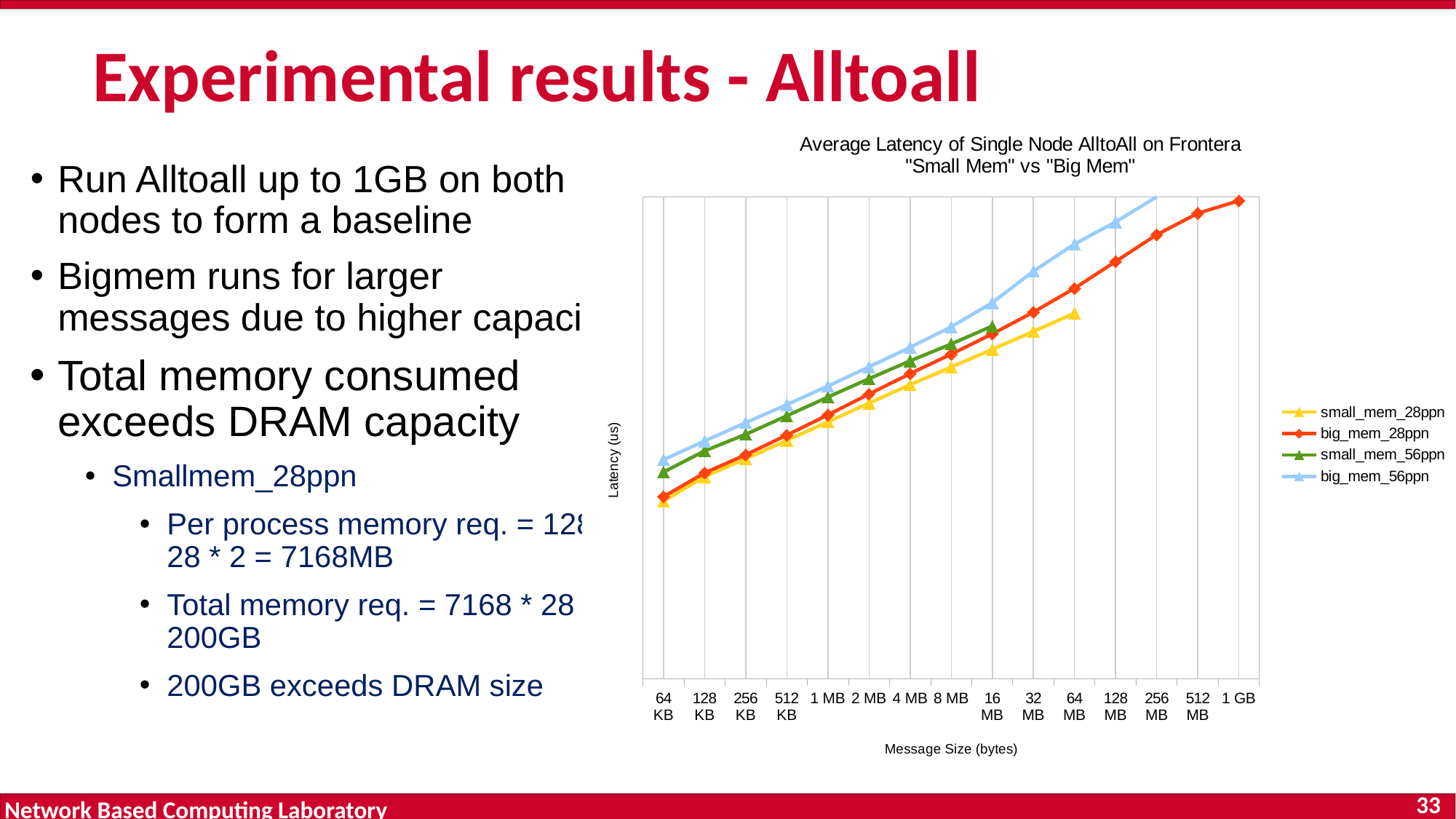
How many message sizes are shown along the x axis? 15 How many series does the legend list? 4 What is the label of the y axis? Latency (us) At 64 KB, which series has the highest latency? big_mem_56ppn At 1 MB, which is larger: the latency for big_mem_56ppn or for big_mem_28ppn? big_mem_56ppn At 64 KB, which series has the lowest latency? small_mem_28ppn At 16 MB, which is larger: the latency for small_mem_56ppn or for small_mem_28ppn? small_mem_56ppn What kind of chart is shown on the slide? line chart Does latency rise or fall as message size increases along the x axis? rise Which series extends all the way to the 1 GB message size? big_mem_28ppn